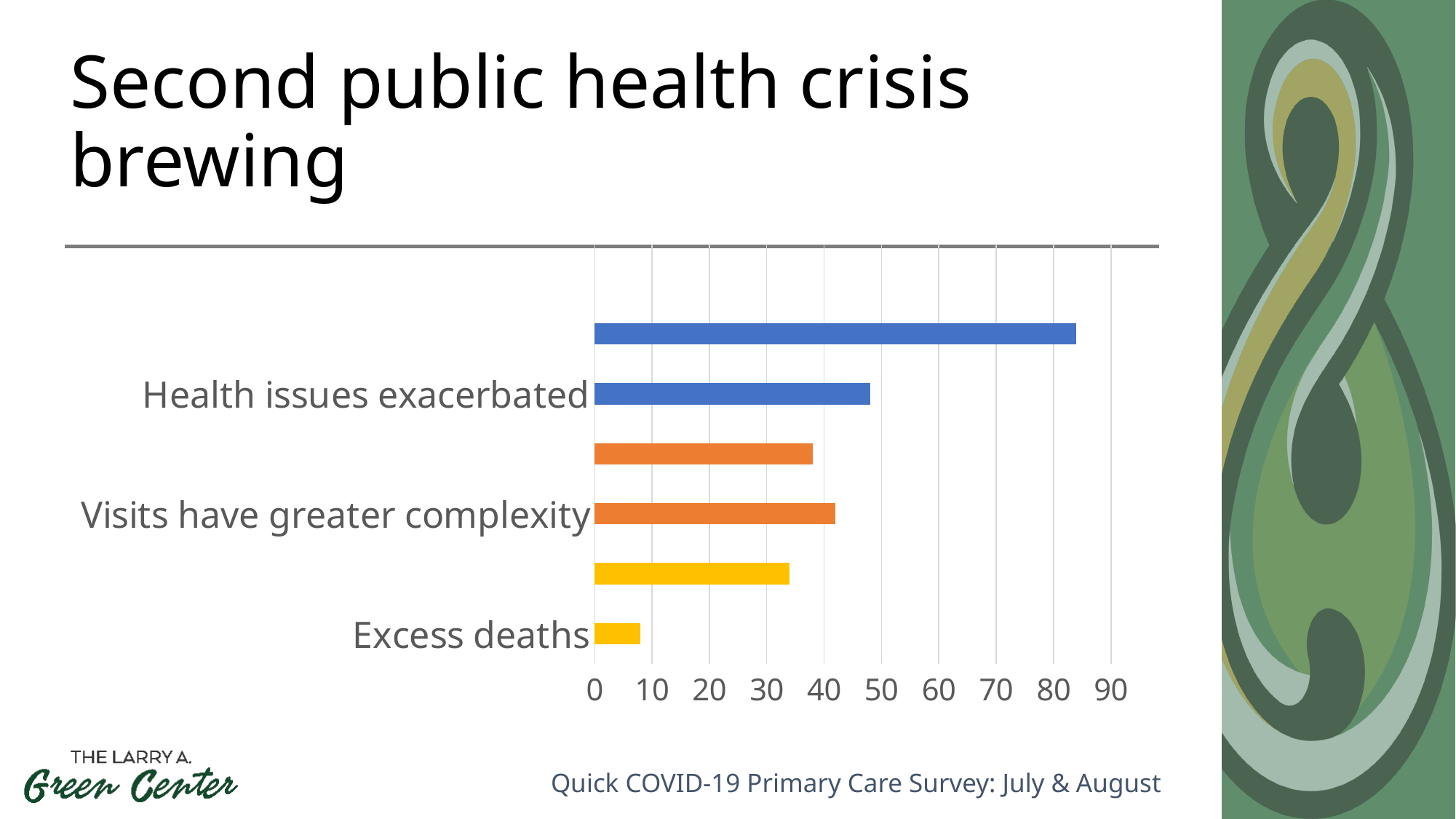
Is the value of the shortest bar for Excess deaths greater or less than 10? less What kind of chart is shown on the slide? bar chart How many categories are shown on the chart's vertical axis? 3 What colour are the bars for Excess deaths? yellow Which category has longer bars overall: Health issues exacerbated or Excess deaths? Health issues exacerbated Which category has the shortest bar on the chart? Excess deaths What is the highest value shown on the chart's horizontal axis? 90